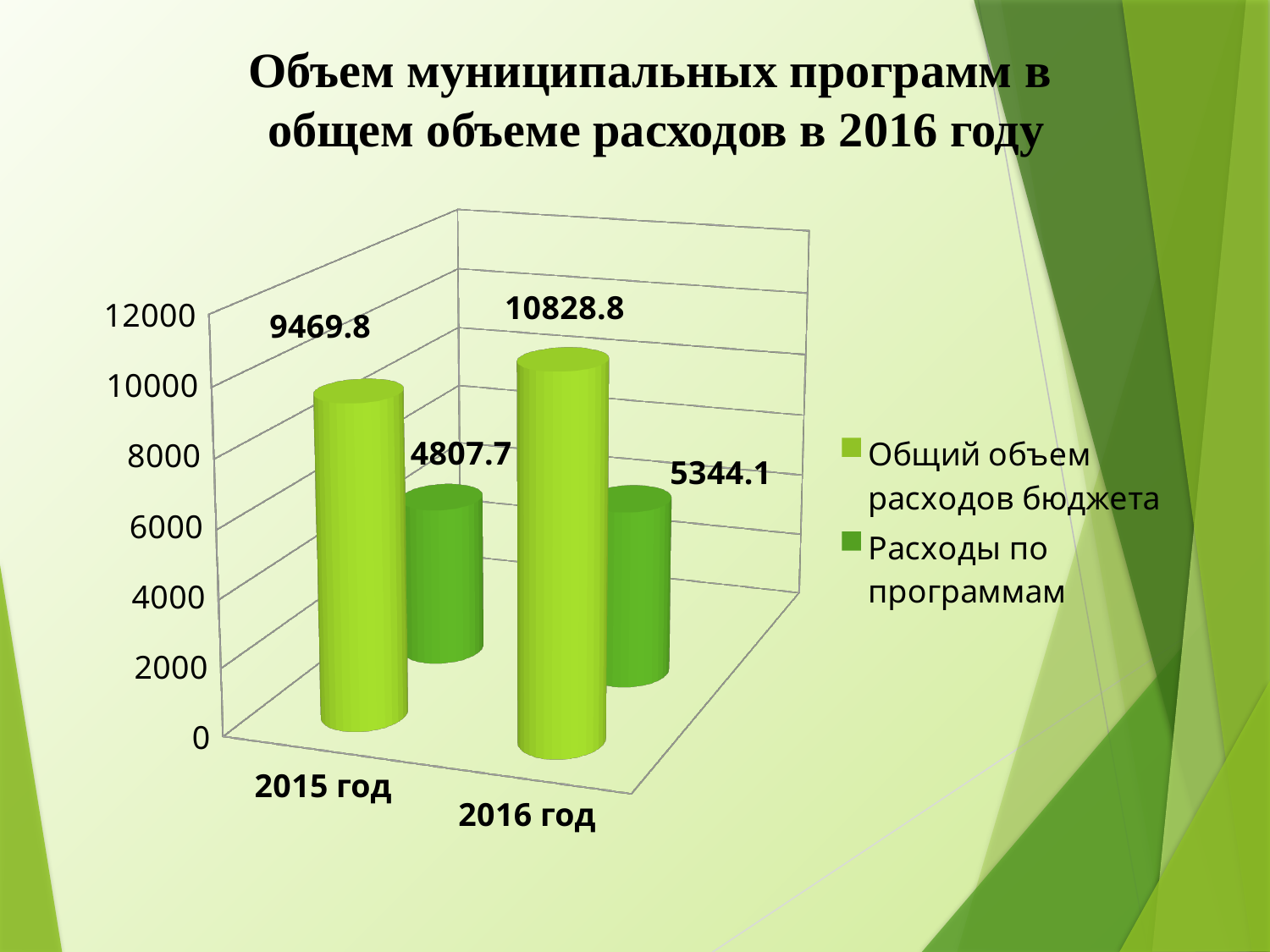
What is the difference between "Общий объем расходов бюджета" in 2016 год and in 2015 год? 1359.0 What is the value of "Расходы по программам" for 2016 год? 5344.1 What is the value of "Общий объем расходов бюджета" for 2015 год? 9469.8 Which year has the lower value for "Расходы по программам"? 2015 год What is the difference between "Общий объем расходов бюджета" and "Расходы по программам" in 2016 год? 5484.7 What is the value of "Общий объем расходов бюджета" for 2016 год? 10828.8 Which year has the higher value for "Общий объем расходов бюджета"? 2016 год How many series does the legend list? 2 Does "Расходы по программам" rise or fall from 2015 год to 2016 год? rise Is "Расходы по программам" in 2016 год greater or less than 6000? less What is the value of "Расходы по программам" for 2015 год? 4807.7 What kind of chart is shown on the slide? bar chart